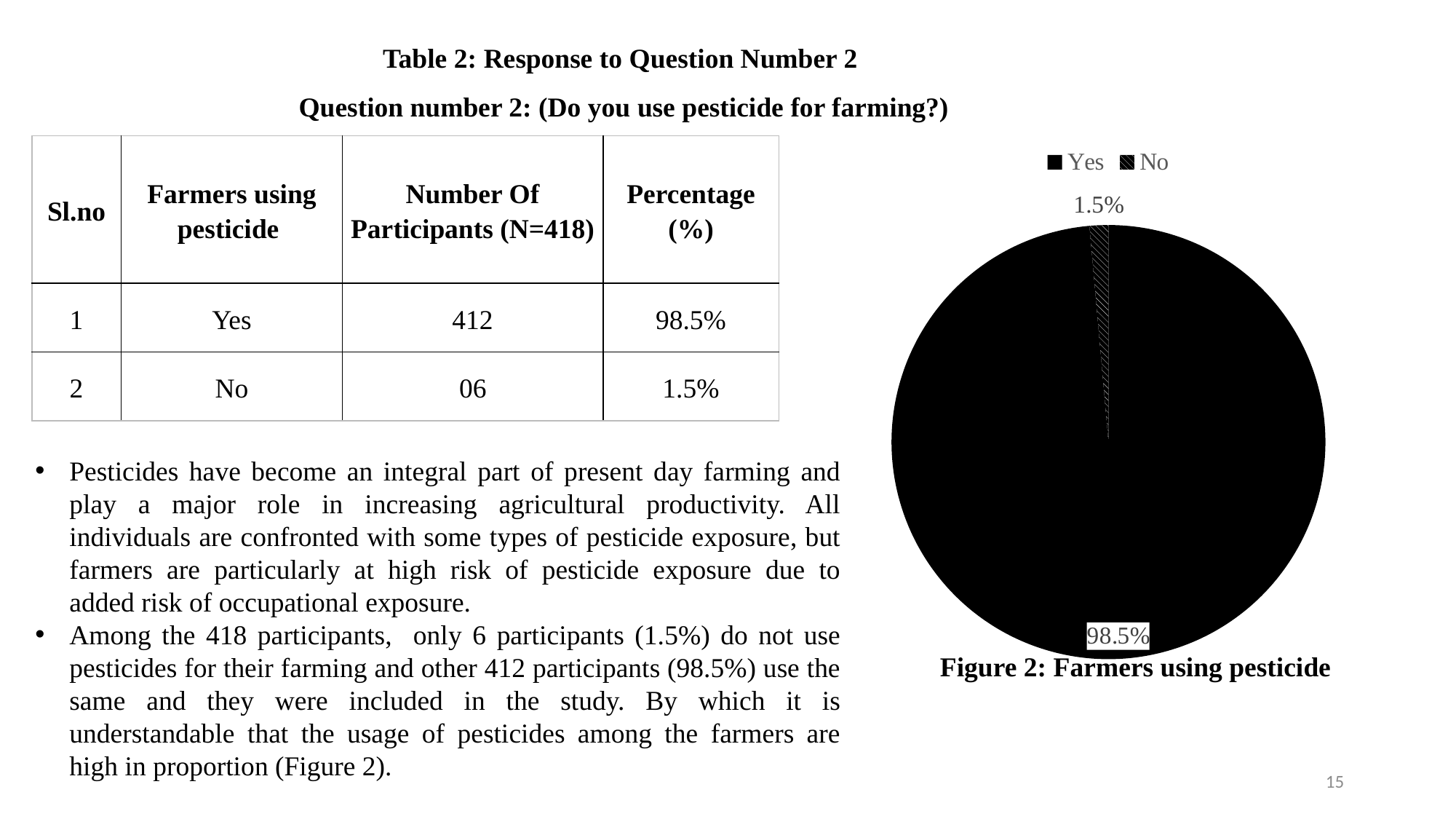
Which legend entry of the pie chart is shown with a hatched pattern? No How many entries does the legend of the pie chart list? 2 Is the Yes slice of the pie chart greater or less than 50%? greater Which slice of the pie chart is the largest? Yes What is the difference in percentage points between the Yes and No slices of the pie chart? 97 percentage points Which slice of the pie chart is the smallest? No In the pie chart, what percentage is shown for Yes? 98.5% What is the caption of the pie chart? Figure 2: Farmers using pesticide What kind of chart is Figure 2: Farmers using pesticide? pie chart How many slices does the pie chart have? 2 In the pie chart, what percentage is shown for No? 1.5% In the pie chart, which is larger, the Yes slice or the No slice? Yes